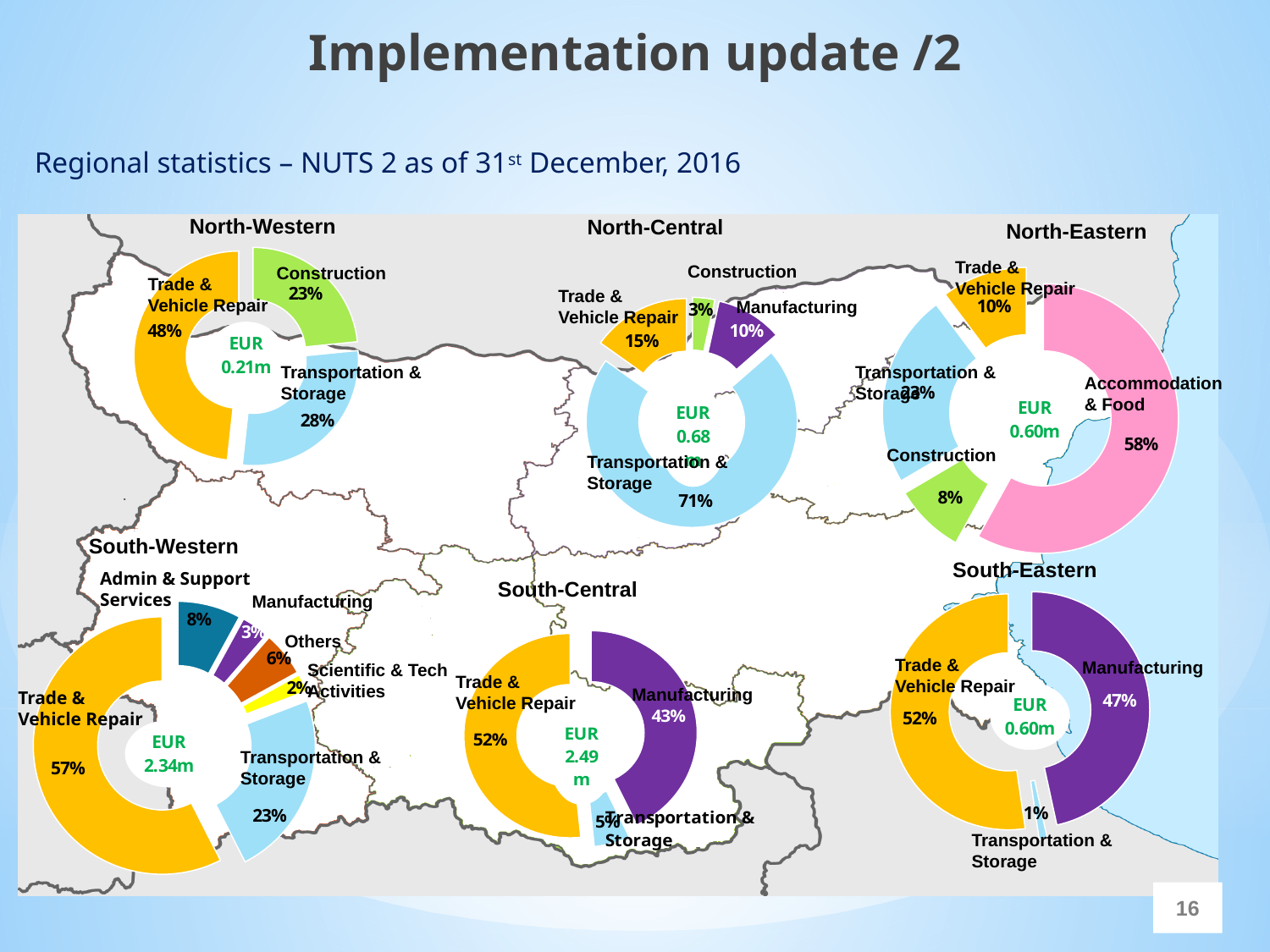
What total amount is shown in the centre of the North-Central chart? EUR 0.68m In the North-Western chart, what share does Trade & Vehicle Repair hold? 48% In the South-Western chart, what share does Admin & Support Services hold? 8% What total amount is shown in the centre of the South-Western chart? EUR 2.34m In the South-Central chart, which category has the largest share? Trade & Vehicle Repair What kind of chart is used for each region on the slide? Pie (donut) chart In the North-Eastern chart, what share does Accommodation & Food hold? 58% In the South-Central chart, which is larger: Manufacturing or Transportation & Storage? Manufacturing In the North-Central chart, what share does Transportation & Storage hold? 71% In the North-Western chart, what is the difference between the Transportation & Storage share and the Construction share? 5% In the South-Eastern chart, which category has the smallest share? Transportation & Storage How many categories are shown in the South-Western chart? 6